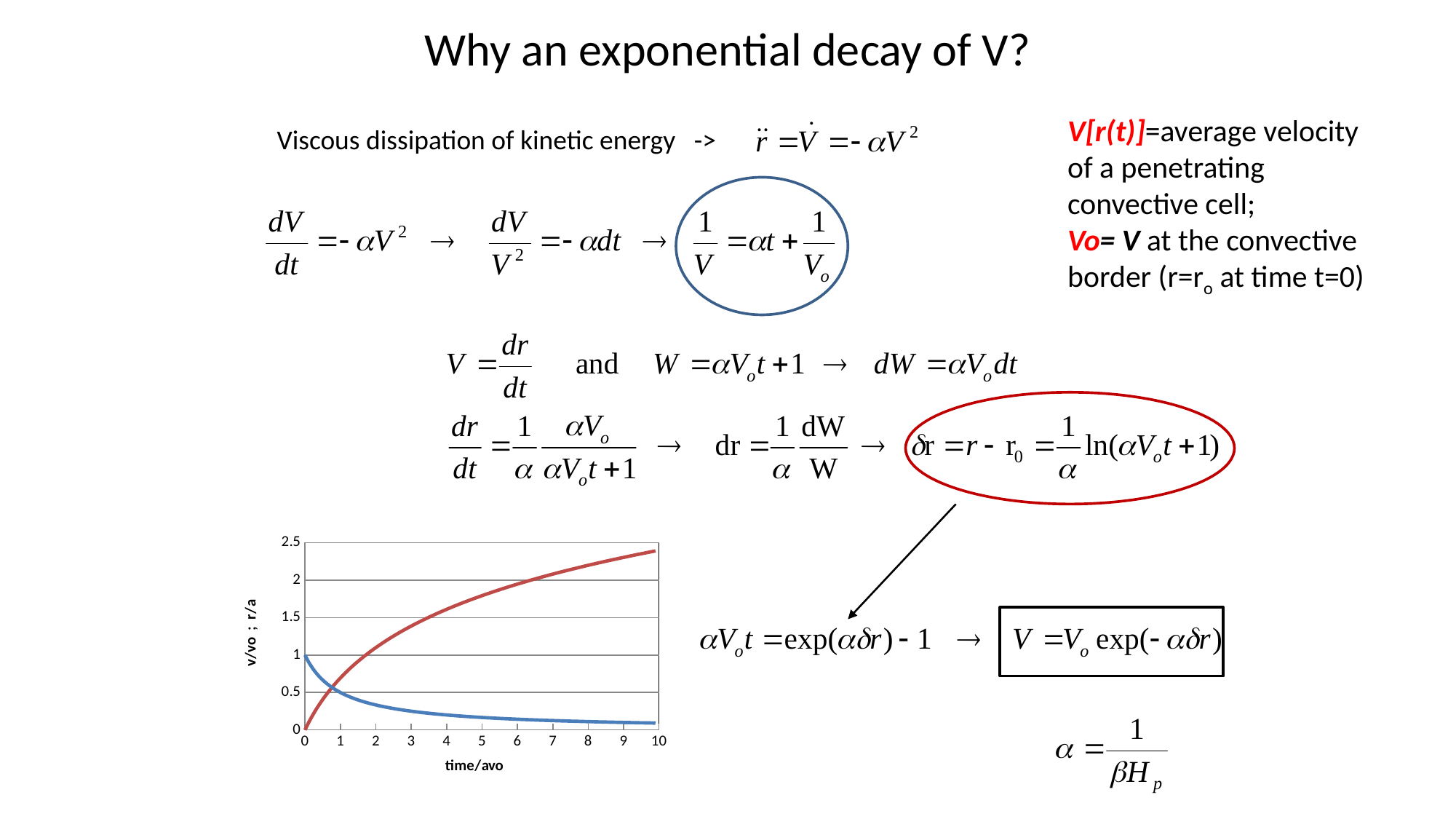
Is the value of the red line at time/avo = 10 greater or less than 2? greater What is the value of the blue line at time/avo = 0? 1 What kind of chart is shown on the slide? line chart How many lines are plotted on the chart? 2 What is the label of the x axis of the chart? time/avo Is the value of the blue line at time/avo = 5 greater or less than 0.5? less At time/avo = 10, which line has the larger value, the red line or the blue line? red line Is the value of the red line at time/avo = 5 greater or less than 1.5? greater Does the blue line rise or fall as time/avo increases? fall What is the label of the y axis of the chart? v/vo ; r/a Does the red line rise or fall as time/avo increases? rise What is the value of the red line at time/avo = 0? 0